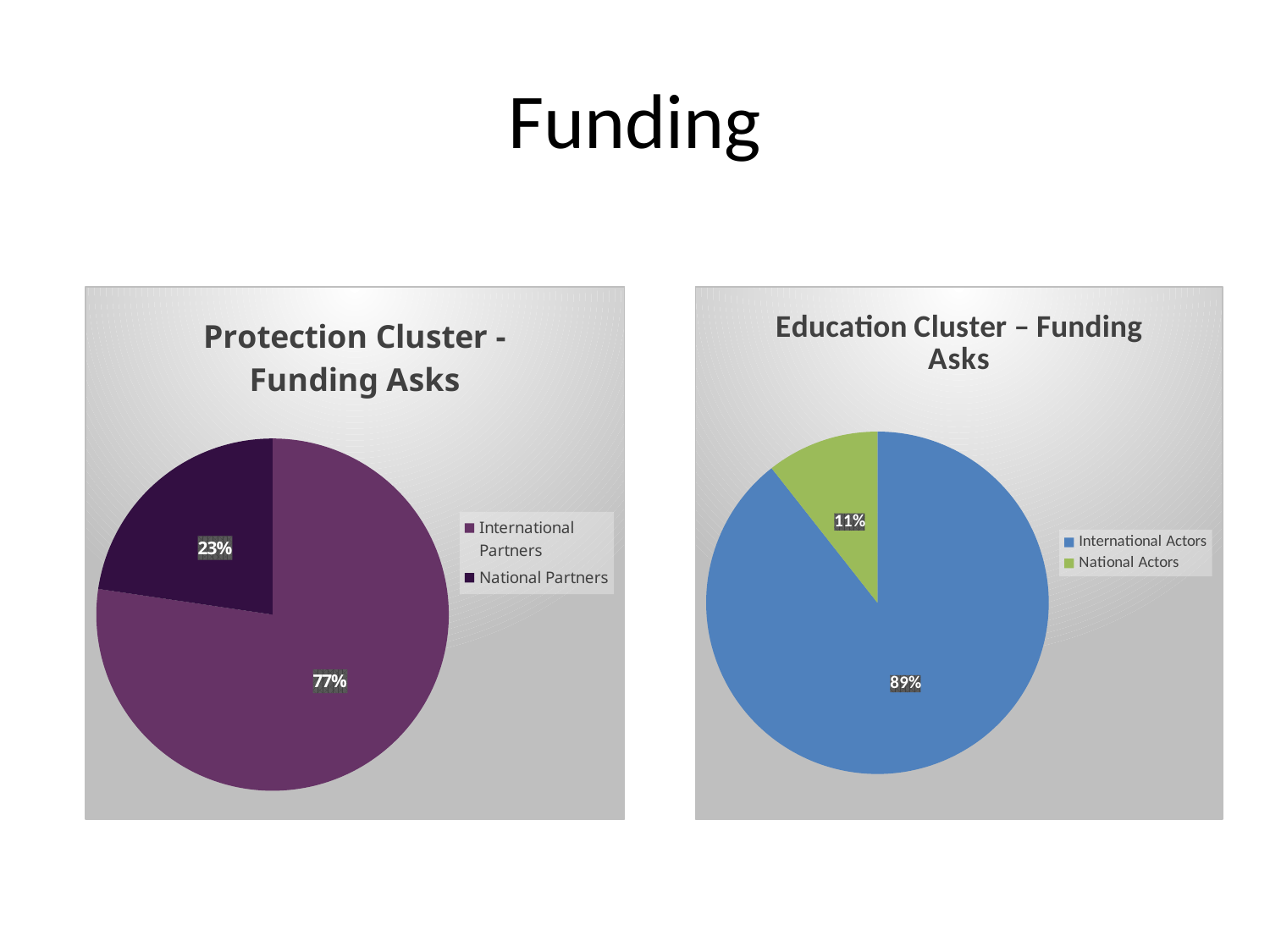
In the Protection Cluster - Funding Asks chart, what share of funding asks is for National Partners? 23% In the Protection Cluster - Funding Asks chart, what share of funding asks is for International Partners? 77% In the Education Cluster – Funding Asks chart, what is the difference in percentage points between International Actors and National Actors? 78 In the Education Cluster – Funding Asks chart, what share of funding asks is for International Actors? 89% What type of chart is the Education Cluster – Funding Asks chart? Pie chart In the Education Cluster – Funding Asks chart, which category has the smallest slice? National Actors In the Protection Cluster - Funding Asks chart, what is the difference in percentage points between International Partners and National Partners? 54 Which is larger: the National Partners share in the Protection Cluster chart or the National Actors share in the Education Cluster chart? National Partners share in the Protection Cluster chart How many categories does the legend of the Protection Cluster - Funding Asks chart list? 2 In the Education Cluster – Funding Asks chart, what colour is the International Actors slice? Blue In the Protection Cluster - Funding Asks chart, which category has the largest slice? International Partners